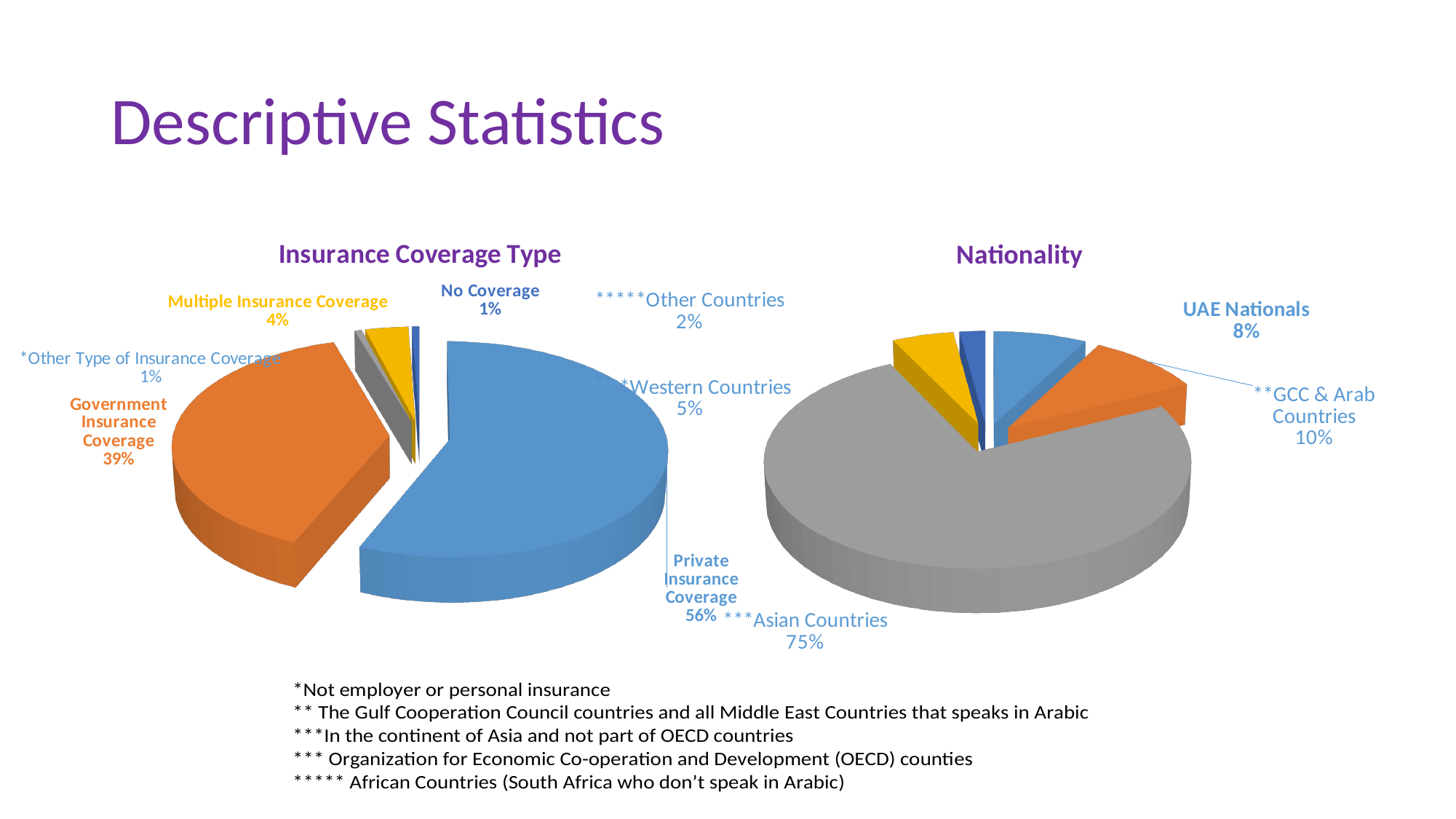
In the Insurance Coverage Type chart, what share is Government Insurance Coverage? 39% In the Insurance Coverage Type chart, which category has the largest share? Private Insurance Coverage In the Insurance Coverage Type chart, what is the difference between Private Insurance Coverage and Government Insurance Coverage? 17% In the Insurance Coverage Type chart, what share is Private Insurance Coverage? 56% In the Nationality chart, what share is UAE Nationals? 8% In the Insurance Coverage Type chart, how many categories are shown? 5 In the Nationality chart, what share is Asian Countries? 75% What is the title of the chart on the left of the slide? Insurance Coverage Type In the Nationality chart, what share is GCC & Arab Countries? 10% What kind of chart is the Nationality chart? Pie chart In the Nationality chart, which category has the smallest share? Other Countries In the Nationality chart, which is larger, GCC & Arab Countries or Western Countries? GCC & Arab Countries